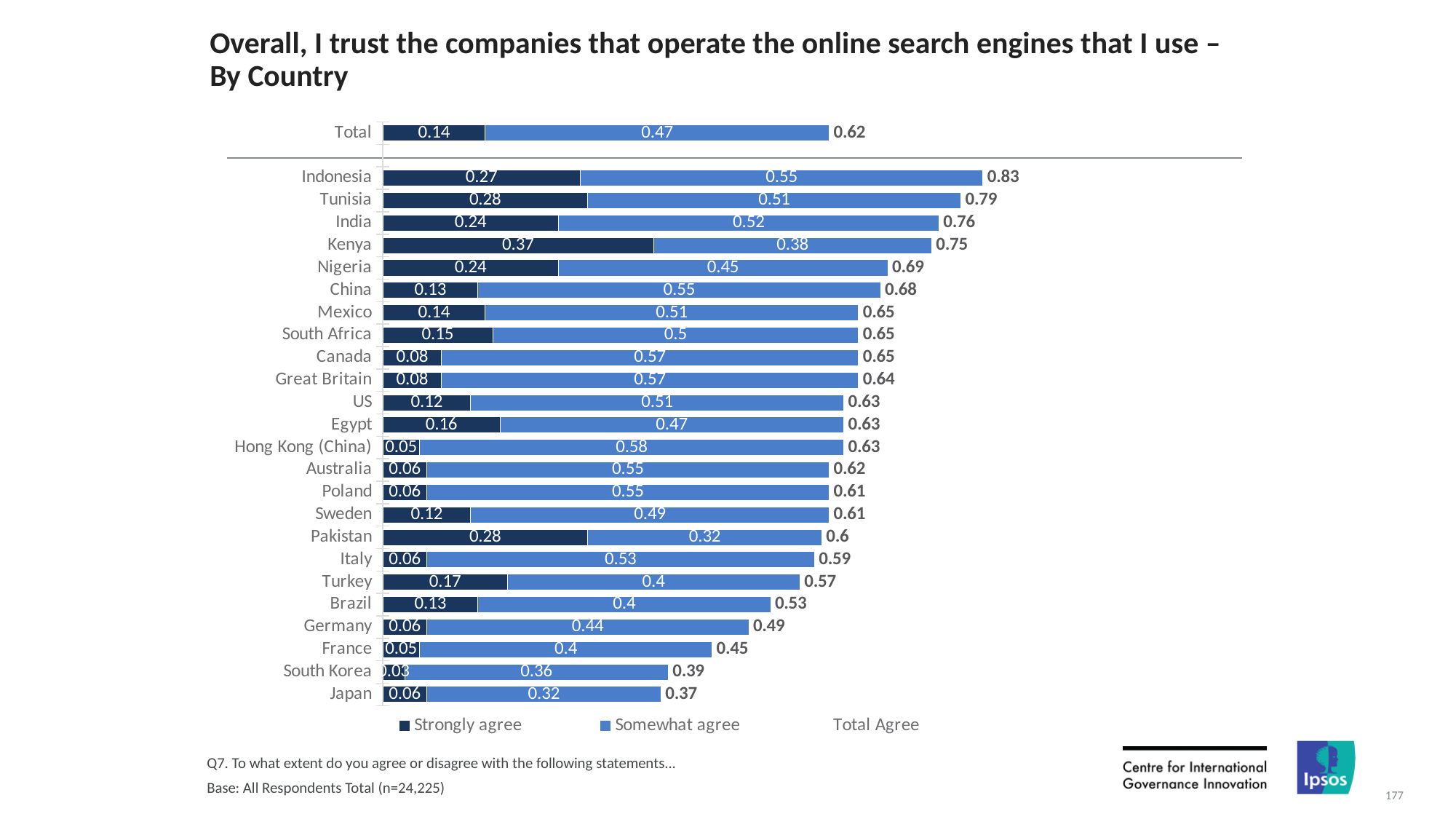
Which has a larger Strongly agree value, Tunisia or India? Tunisia What is the title of the chart? Overall, I trust the companies that operate the online search engines that I use – By Country How many countries are listed in the chart, excluding the Total row? 24 Which country has the highest Strongly agree value? Kenya What is the difference between the Total Agree values for Indonesia and Japan? 0.46 Which country has the lowest Total Agree value? Japan What is the Total Agree value for the Total row? 0.62 What is the Strongly agree value for Kenya? 0.37 Which country has the highest Total Agree value? Indonesia What is the Somewhat agree value for Hong Kong (China)? 0.58 What kind of chart is shown on the slide? Stacked bar chart How many entries does the legend list? 3